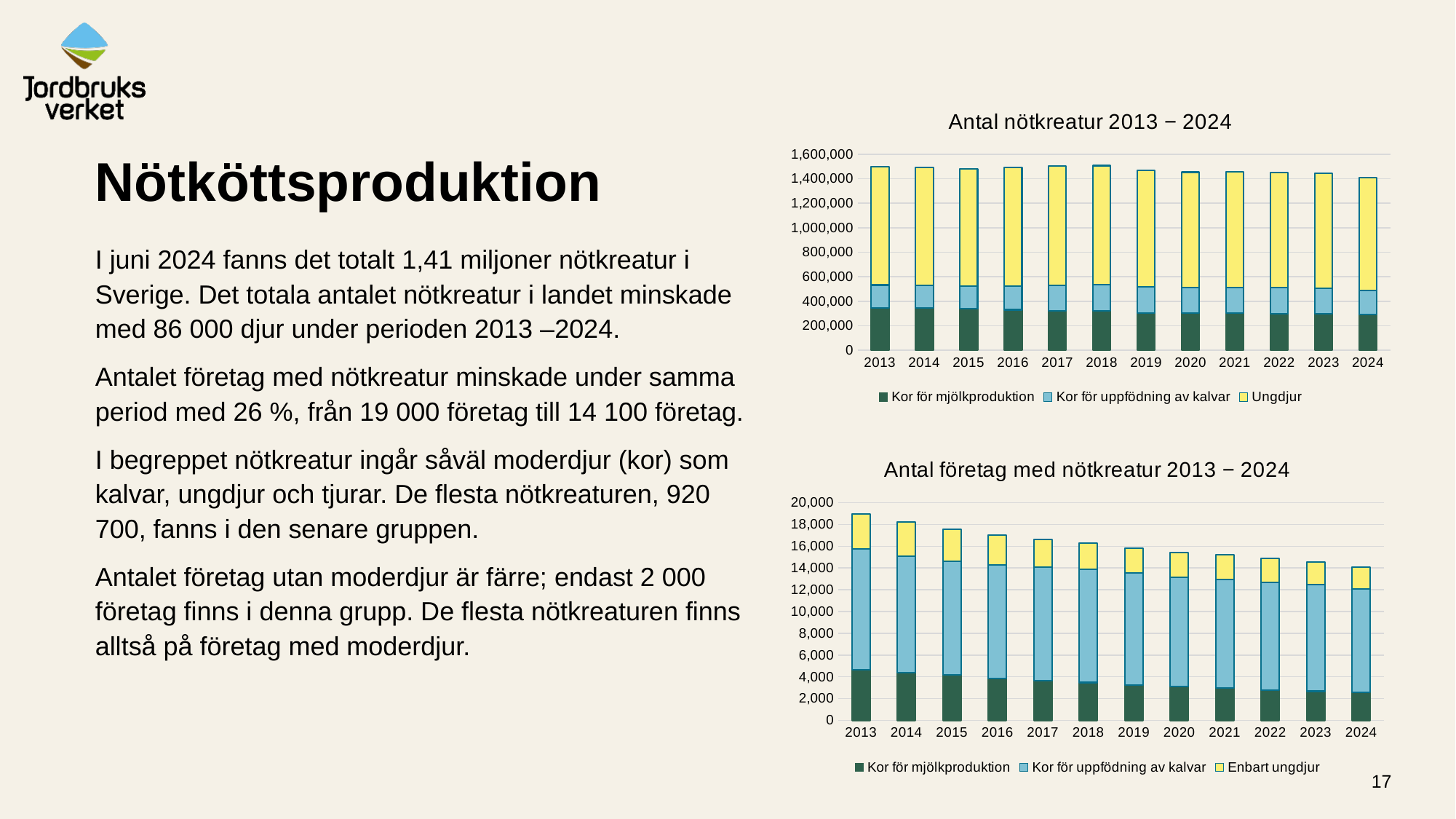
In the 'Antal företag med nötkreatur 2013 − 2024' chart, do the total values rise or fall from 2013 to 2024? fall In the 'Antal företag med nötkreatur 2013 − 2024' chart, which year has the highest total number of companies? 2013 Which series is shown in yellow in the 'Antal nötkreatur 2013 − 2024' chart? Ungdjur How many years are shown on the x axis of the 'Antal nötkreatur 2013 − 2024' chart? 12 In the 'Antal nötkreatur 2013 − 2024' chart, is the 'Kor för mjölkproduktion' value for 2013 greater or less than 400,000? less In the 'Antal nötkreatur 2013 − 2024' chart, is the total for 2024 greater or less than 1,600,000? less What is the title of the lower chart on the slide? Antal företag med nötkreatur 2013 − 2024 In the 'Antal företag med nötkreatur 2013 − 2024' chart, is the total for 2013 greater or less than 18,000? greater How many series does the legend of the 'Antal nötkreatur 2013 − 2024' chart list? 3 What kind of chart is the 'Antal nötkreatur 2013 − 2024' chart? Stacked bar chart In the 'Antal nötkreatur 2013 − 2024' chart, which year has the lowest total number of cattle? 2024 In the 'Antal företag med nötkreatur 2013 − 2024' chart, which year has the lowest total number of companies? 2024